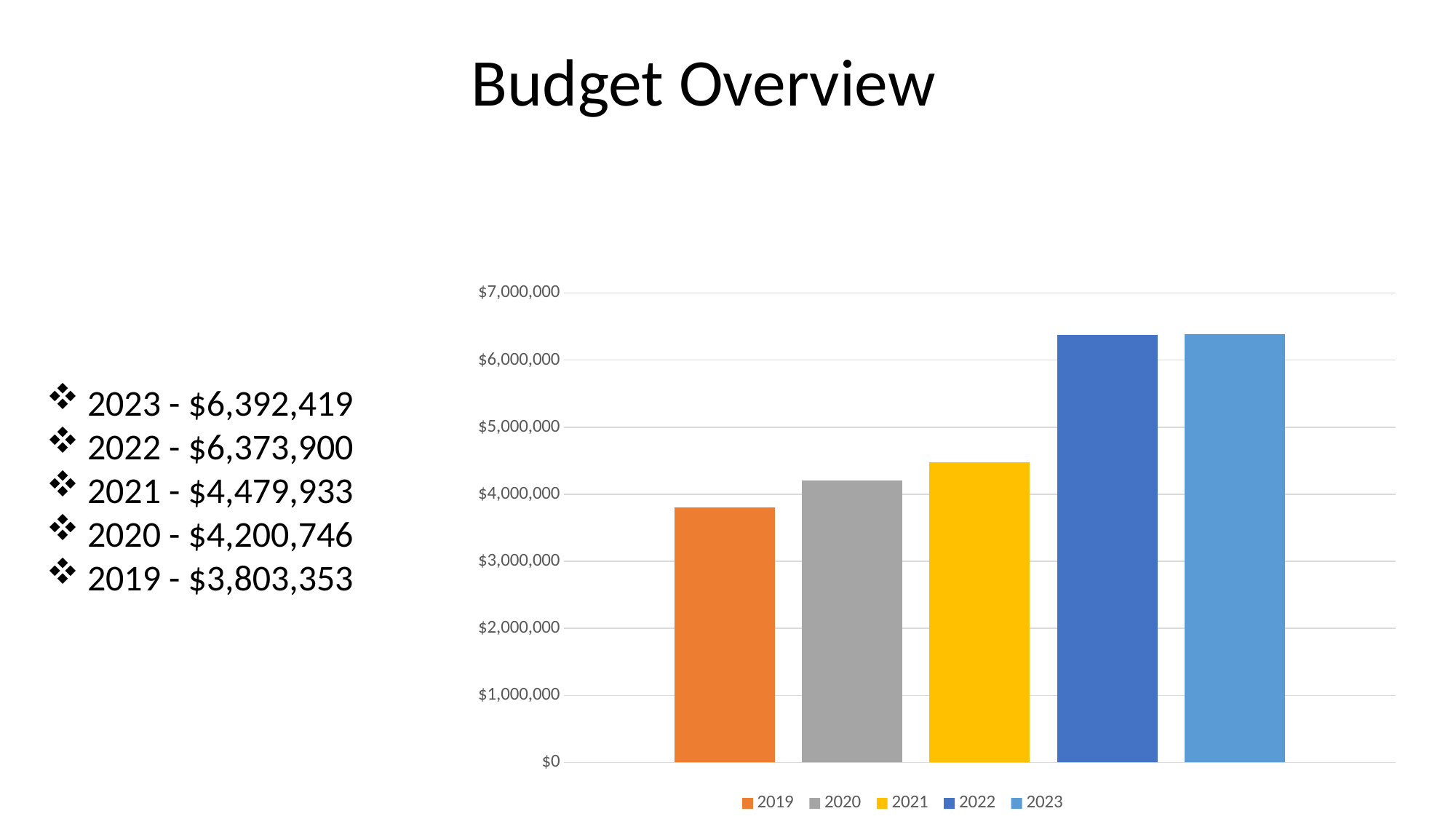
Is the value for 2019 greater or less than $4,000,000? less What is the budget value for 2023 shown on the slide? $6,392,419 Which is larger, the budget for 2021 or the budget for 2020? 2021 Which year has the lowest budget in the chart? 2019 How many bars are plotted in the chart? 5 Do the budget values rise or fall from 2019 to 2023? Rise What is the budget value for 2019 shown on the slide? $3,803,353 What is the budget value for 2021 shown on the slide? $4,479,933 What kind of chart is shown on the slide? Bar chart What is the difference between the 2021 and 2020 budgets? $279,187 What is the difference between the 2023 and 2019 budgets? $2,589,066 Is the value for 2022 greater or less than $6,000,000? greater